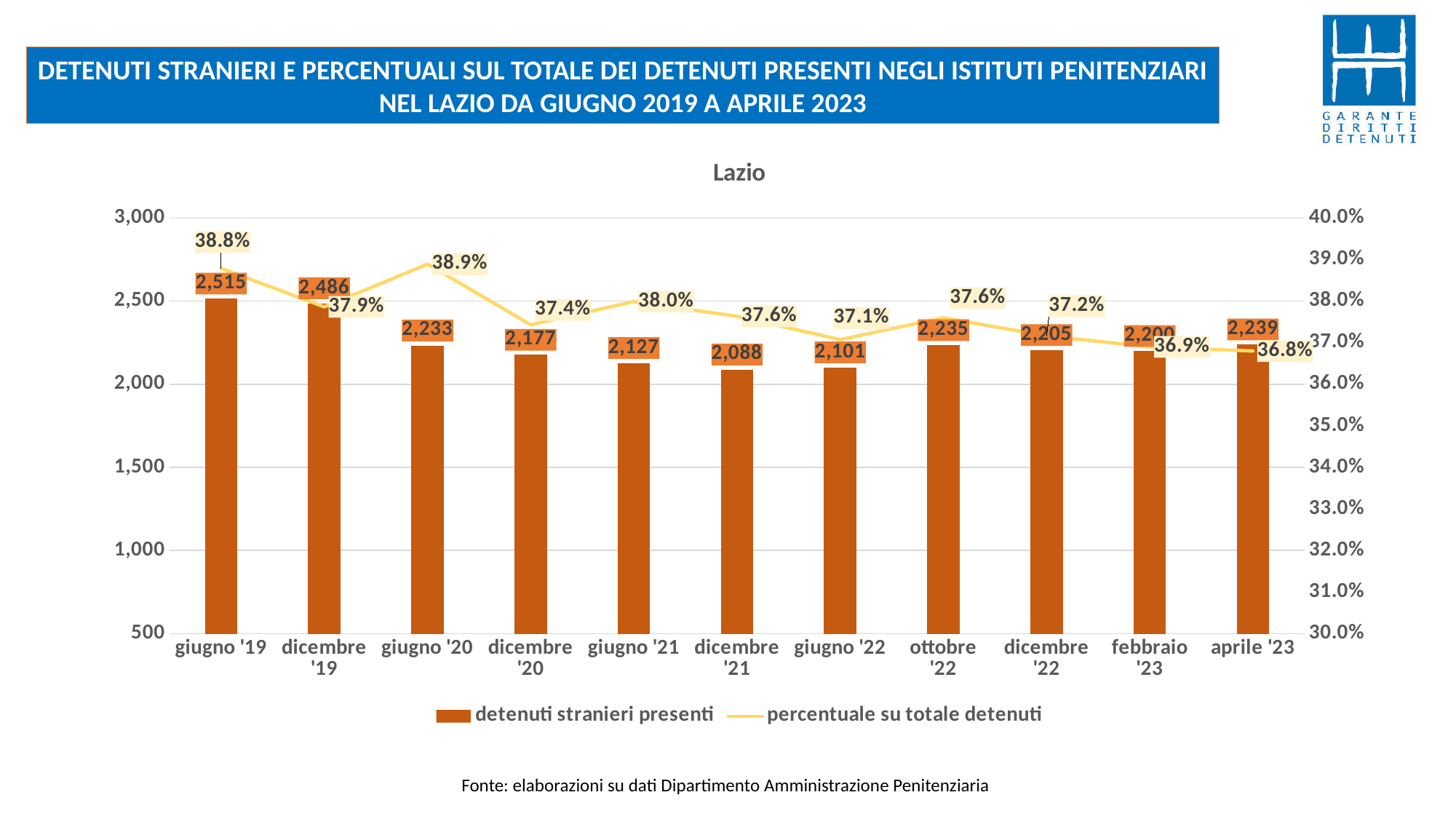
Which is larger: the number of foreign detainees in ottobre '22 or in dicembre '22? ottobre '22 Is the number of foreign detainees in giugno '22 greater or less than 2,500? less How many foreign detainees were present in aprile '23? 2,239 How many series does the legend list? 2 What was the percentage of foreign detainees on the total (percentuale su totale detenuti) in giugno '20? 38.9% What is the difference between the number of foreign detainees in giugno '19 and in dicembre '21? 427 How many foreign detainees (detenuti stranieri presenti) were there in giugno '19? 2,515 Which period has the lowest number of foreign detainees present? dicembre '21 Which period has the highest number of foreign detainees present? giugno '19 How many time periods are shown on the x axis? 11 In which period is the percentage of foreign detainees on the total the lowest? aprile '23 What kind of chart is shown on the slide? Combined bar and line chart